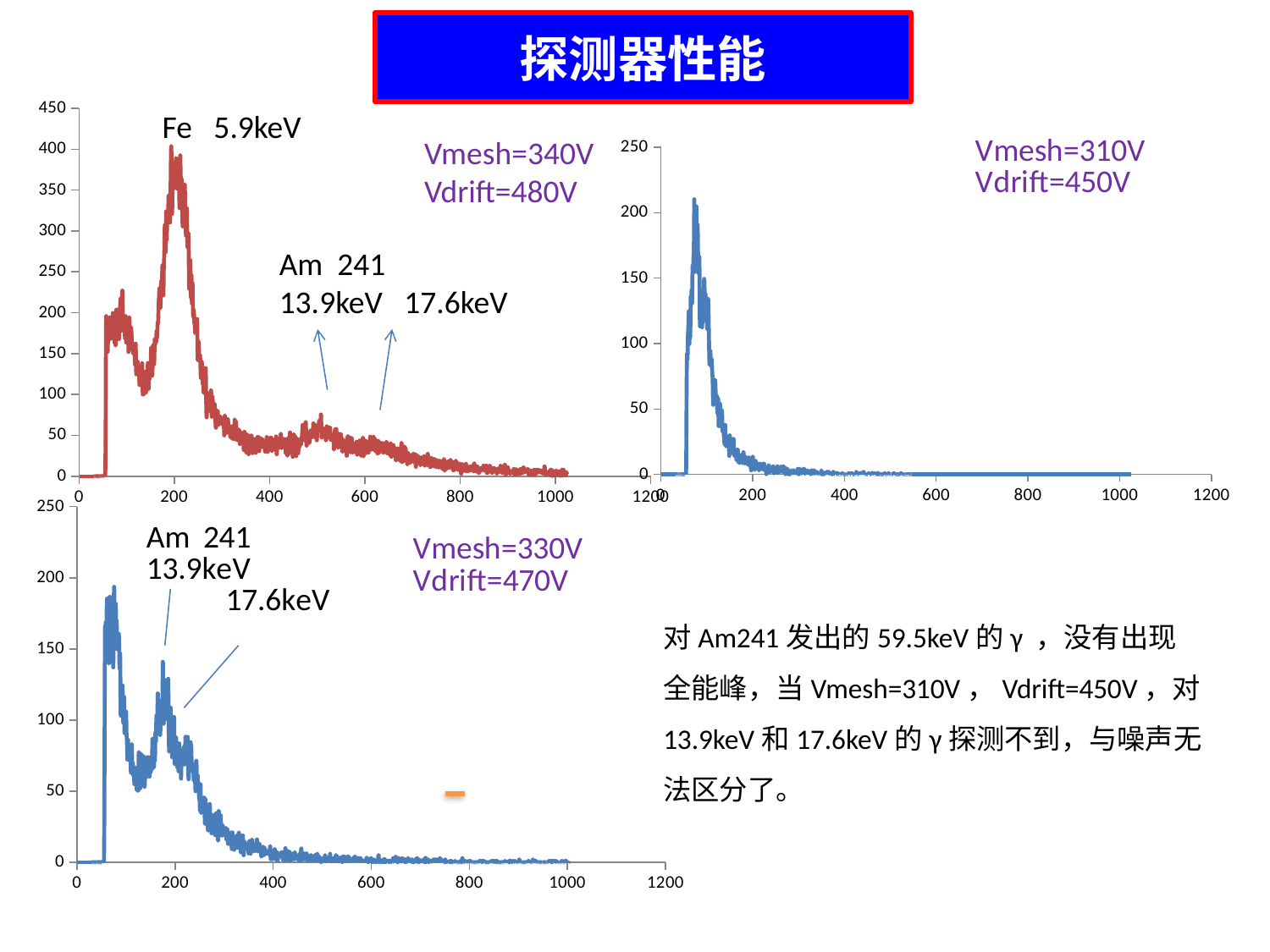
In the bottom-left chart (Vmesh=330V, Vdrift=470V), does the spectrum rise or fall between x=200 and x=400? fall In the top-right chart (Vmesh=310V, Vdrift=450V), is the value at x=600 greater or less than 50? less In the top-right chart (Vmesh=310V, Vdrift=450V), is the highest point of the spectrum greater or less than 150? greater In the top-left chart (Vmesh=340V, Vdrift=480V), is the height of the Fe 5.9keV peak greater or less than 350? greater What kind of chart is the top-left chart (Vmesh=340V, Vdrift=480V)? line chart In the top-left chart (Vmesh=340V, Vdrift=480V), which peak is higher: the Fe 5.9keV peak or the Am 241 13.9keV peak? Fe 5.9keV What is the maximum value shown on the y axis of the top-left chart (Vmesh=340V, Vdrift=480V)? 450 What is the maximum value shown on the y axis of the top-right chart (Vmesh=310V, Vdrift=450V)? 250 In the top-left chart (Vmesh=340V, Vdrift=480V), does the spectrum rise or fall between x=600 and x=1000? fall